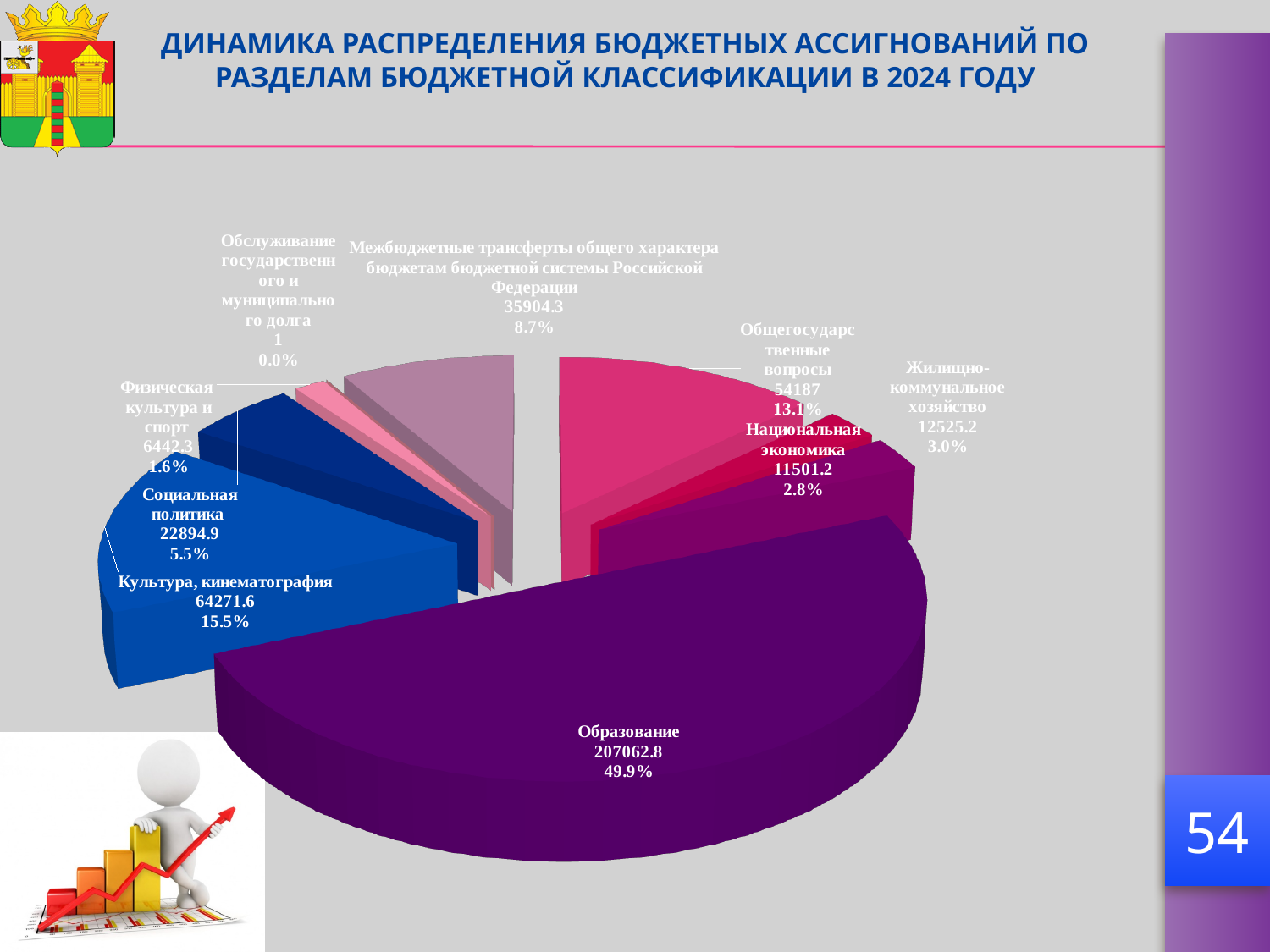
What share of the pie does Общегосударственные вопросы represent? 13.1% What kind of chart is shown on the slide? pie chart What is the value for Культура, кинематография? 64271.6 Which is larger, the value for Физическая культура и спорт or the value for Жилищно-коммунальное хозяйство? Жилищно-коммунальное хозяйство What is the difference between the values for Жилищно-коммунальное хозяйство and Национальная экономика? 1024.0 What is the value for Социальная политика? 22894.9 What share of the pie does Образование represent? 49.9% What is the value for Образование? 207062.8 Which category has the smallest slice of the pie? Обслуживание государственного и муниципального долга How many categories are shown in the pie chart? 9 Which category has the largest slice of the pie? Образование What share of the pie does Межбюджетные трансферты общего характера бюджетам бюджетной системы Российской Федерации represent? 8.7%